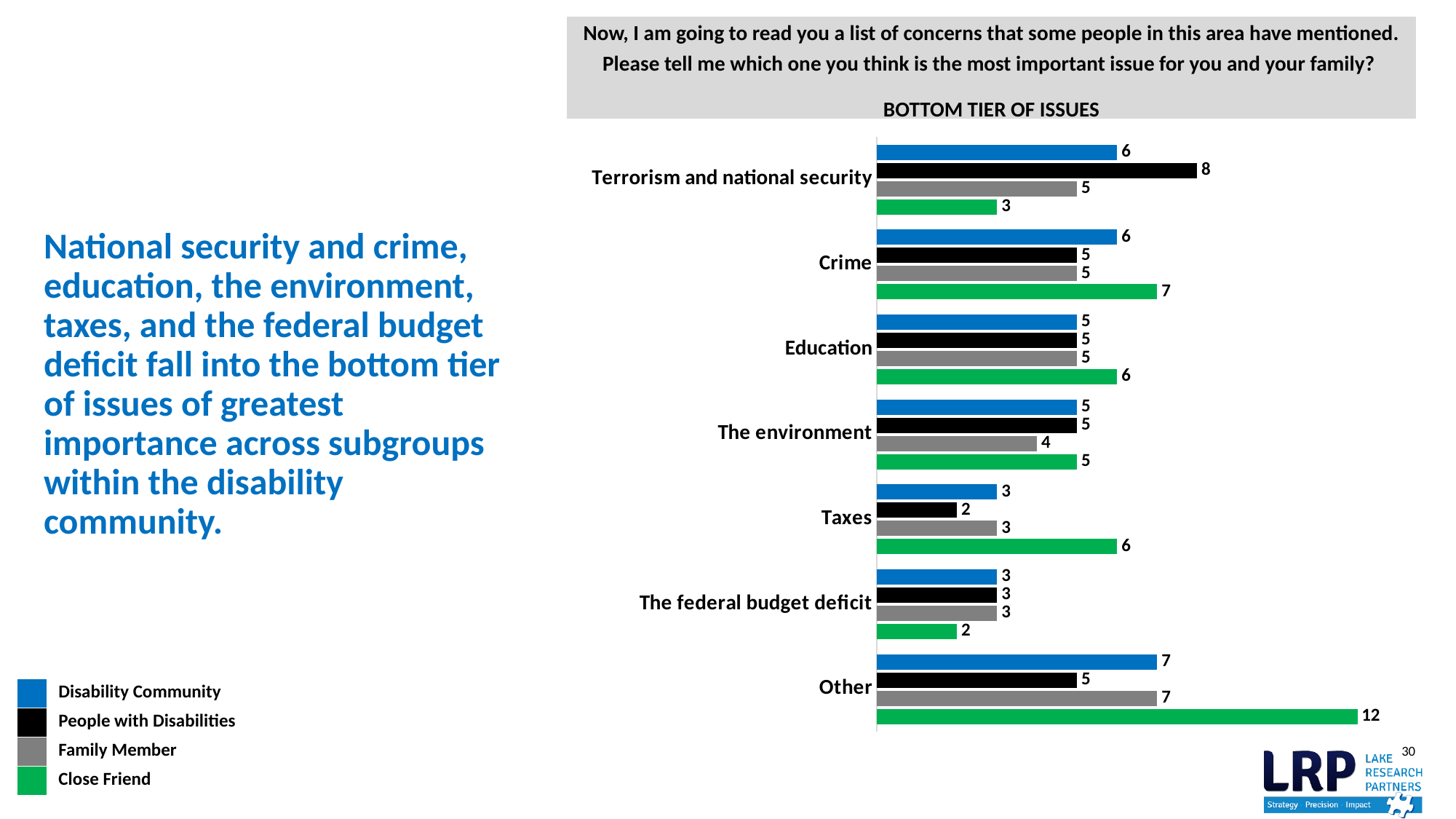
Which category has the highest value for Close Friend? Other What is the value for Family Member on The environment? 4 Which is larger on Crime: the Disability Community value or the Close Friend value? Close Friend Which category has the lowest value for People with Disabilities? Taxes What is the difference between the Close Friend and People with Disabilities values on Taxes? 4 What is the value for Close Friend on Taxes? 6 Which colour represents Family Member in the legend? Gray How many issue categories are shown on the chart? 7 What is the value for Close Friend on Other? 12 What kind of chart is shown on the slide? Bar chart How many series does the legend list? 4 What is the value for People with Disabilities on Terrorism and national security? 8